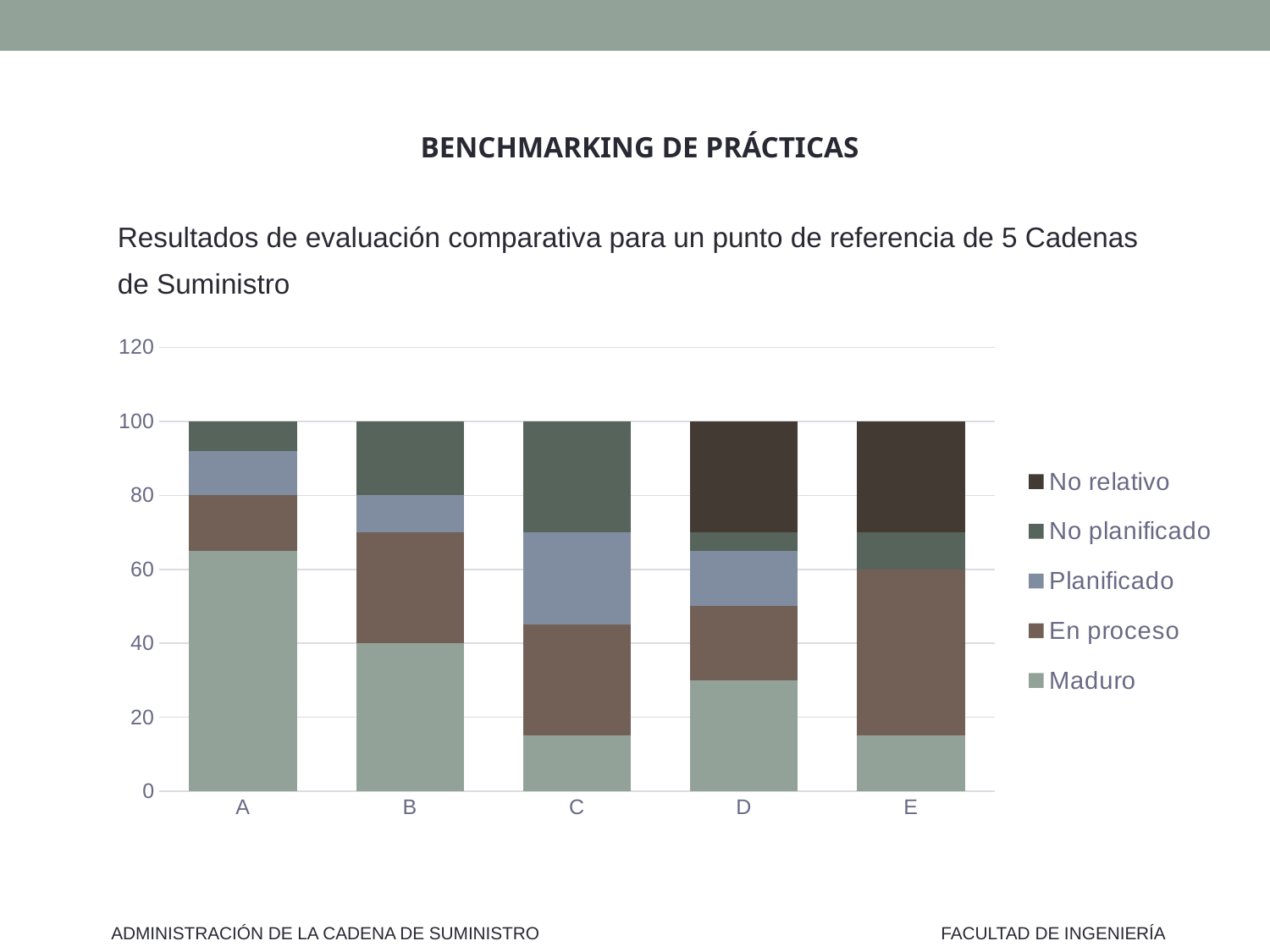
How many series does the chart's legend list? 5 What is the total height of the stacked bar for category A? 100 What is the Maduro value for category B? 40 How many categories are shown on the x axis of the chart? 5 Which category has the highest Maduro value? A What kind of chart is shown on the slide? Stacked bar chart Which series is listed last (at the bottom) in the chart's legend? Maduro Which is larger, the Maduro value for category A or for category B? A Is the Maduro value for category A greater or less than 60? greater Is the Maduro value for category D greater or less than 20? greater Is the Maduro value for category C greater or less than 20? less Which series is listed first (at the top) in the chart's legend? No relativo